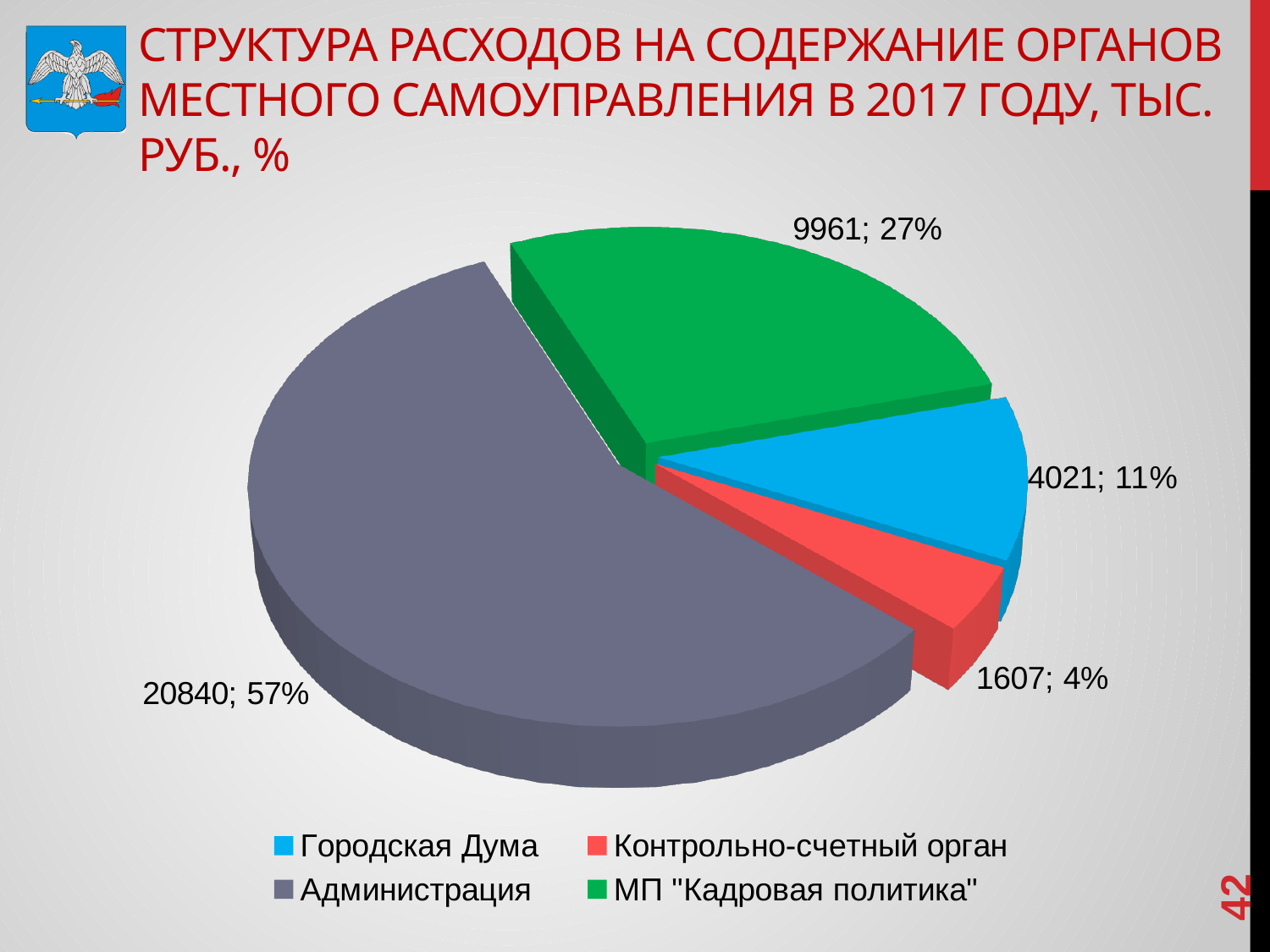
What share of the pie does Контрольно-счетный орган have? 4% What value is shown for Городская Дума? 4021 Which is larger, the value for Городская Дума or the value for Контрольно-счетный орган? Городская Дума What value is shown for Администрация? 20840 What is the difference between the values for Администрация and МП "Кадровая политика"? 10879 What colour is the slice for Администрация? grey Which category has the smallest slice of the pie? Контрольно-счетный орган What share of the pie does МП "Кадровая политика" have? 27% Which category has the largest slice of the pie? Администрация What kind of chart is shown on the slide? pie chart How many categories does the pie chart show? 4 What share of the pie does Городская Дума have? 11%